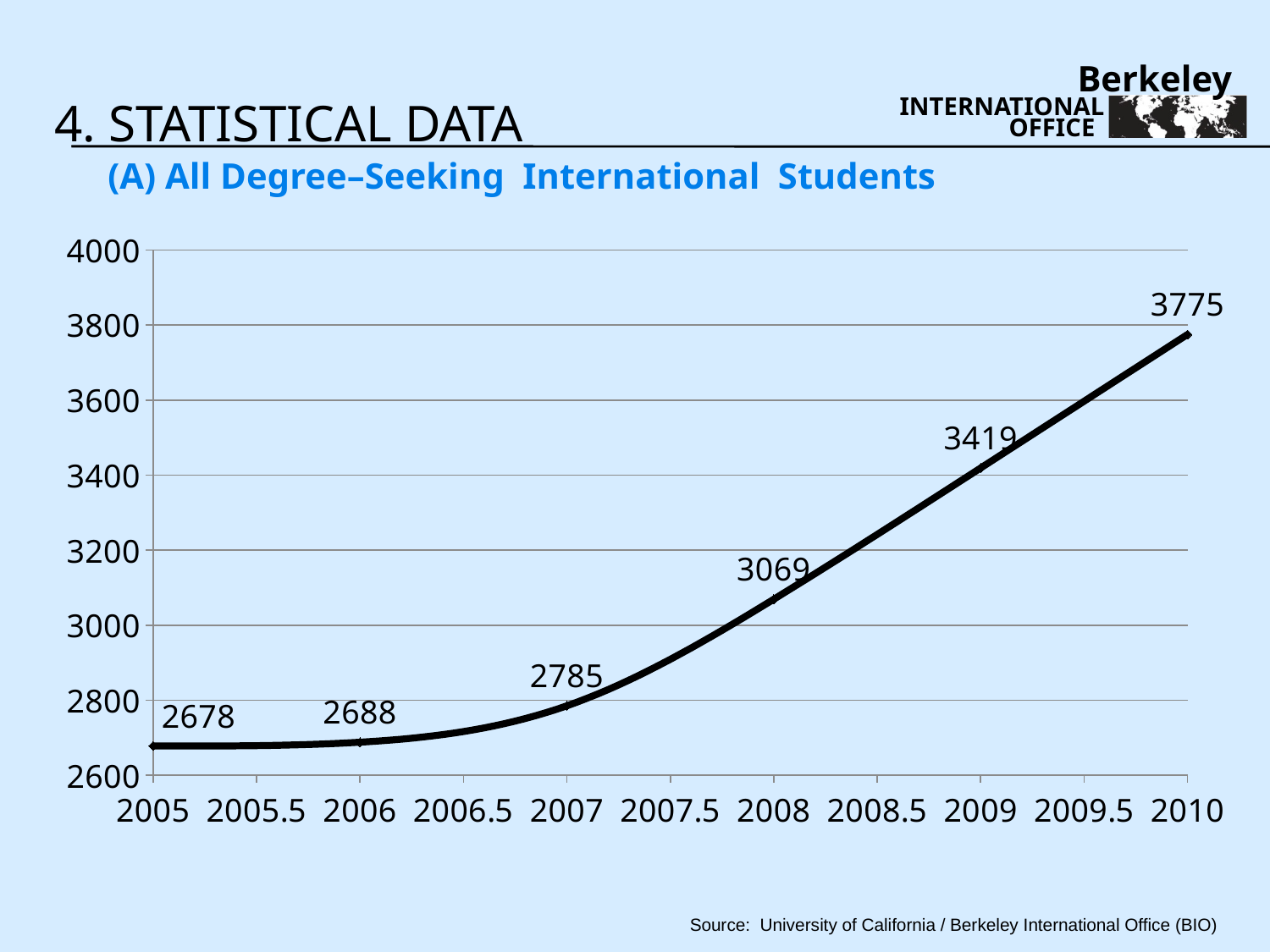
What is the difference between the number of students in 2008 and in 2007? 284 Which year has the lowest number of degree-seeking international students? 2005 What is the number of degree-seeking international students in 2010? 3775 What is the number of degree-seeking international students in 2008? 3069 Which year has the highest number of degree-seeking international students? 2010 What is the difference between the number of students in 2010 and in 2009? 356 What is the number of degree-seeking international students in 2007? 2785 Is the value for 2009 greater or less than 3400? greater What is the number of degree-seeking international students in 2005? 2678 Which year has more degree-seeking international students, 2006 or 2009? 2009 What kind of chart is shown on the slide? line chart Do the values rise or fall from 2005 to 2010? rise